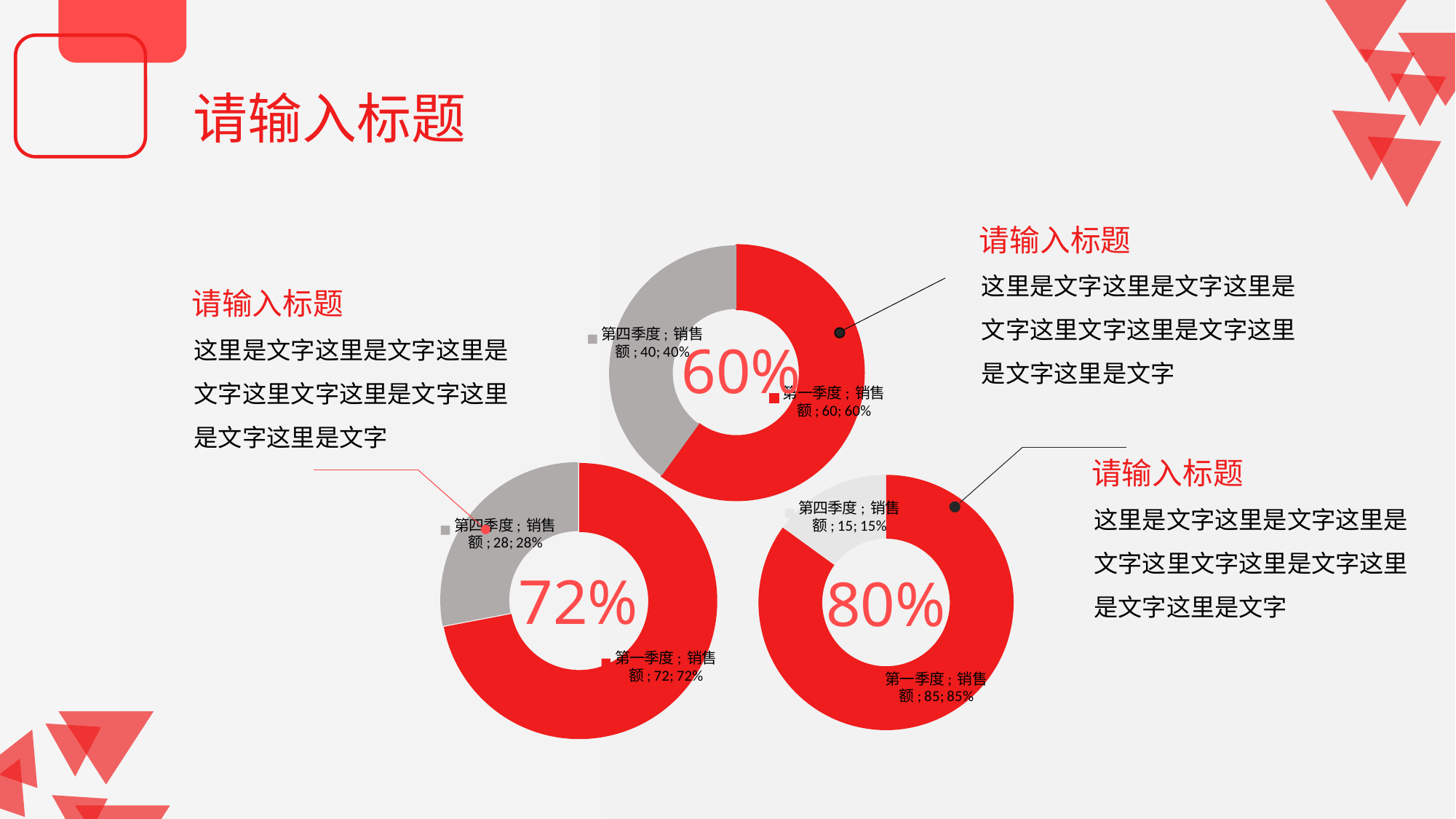
In the top doughnut chart, what percentage share is labelled for 第四季度 销售额? 40% In the top doughnut chart, what is the difference between the 第一季度 value and the 第四季度 value? 20 In the bottom-right doughnut chart, what percentage share is labelled for 第四季度 销售额? 15% How many slices does the bottom-right doughnut chart have? 2 In the bottom-left doughnut chart, what percentage share is labelled for 第一季度 销售额? 72% What type of chart is used for the three charts on the slide? Doughnut chart In the bottom-left doughnut chart, what is the difference between the 第一季度 value and the 第四季度 value? 44 In the bottom-left doughnut chart, what is the value labelled for 第四季度 销售额? 28 In the top doughnut chart, what is the value labelled for 第一季度 销售额? 60 In the bottom-right doughnut chart, what is the value labelled for 第一季度 销售额? 85 In the top doughnut chart, which category has the larger slice, 第一季度 or 第四季度? 第一季度 In the bottom-right doughnut chart, which category has the smallest slice? 第四季度